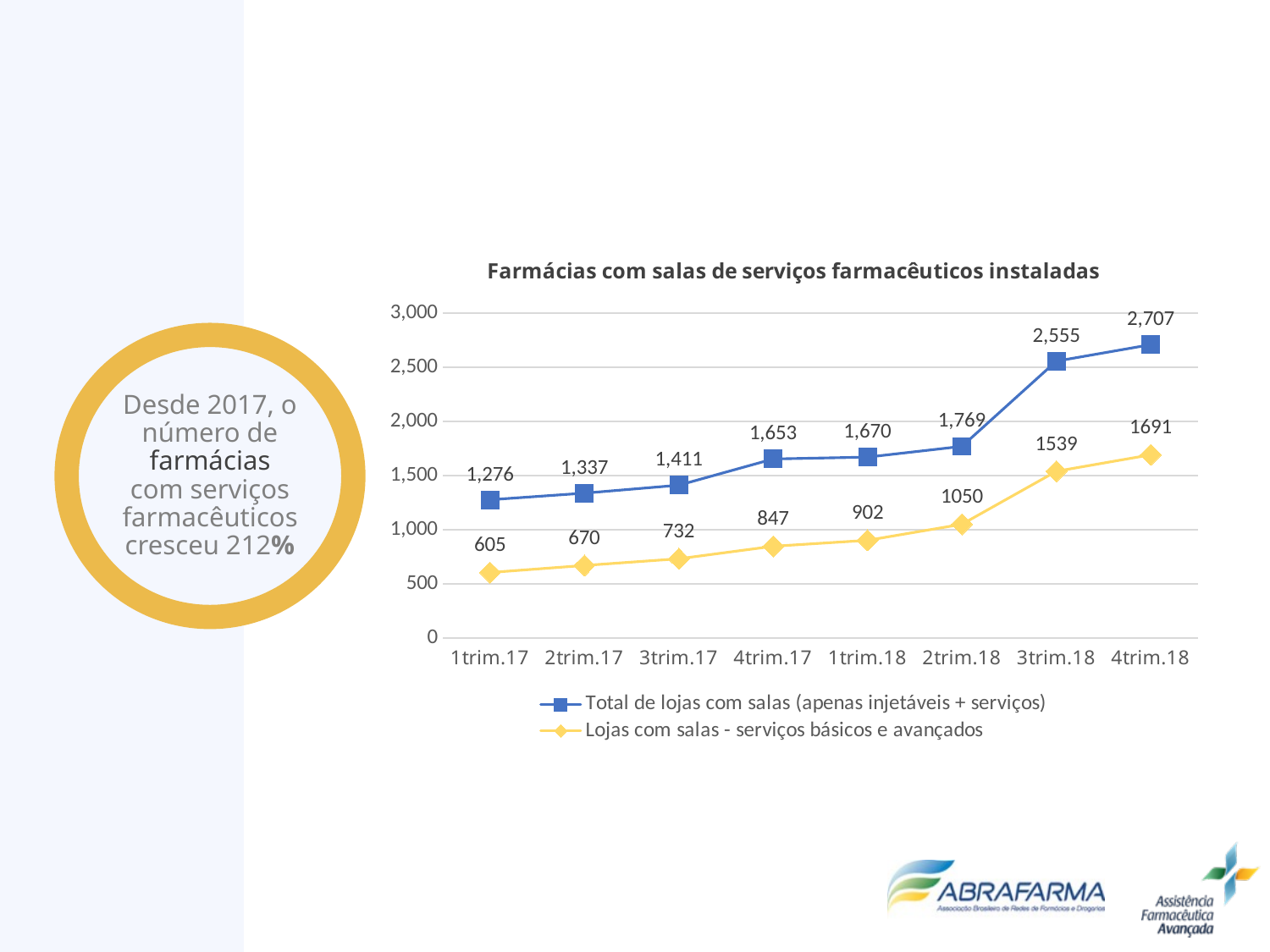
What is the difference between the 'Total de lojas com salas' values for 4trim.18 and 3trim.18? 152 What is the value of 'Lojas com salas - serviços básicos e avançados' for 1trim.17? 605 What kind of chart is shown on the slide? Line chart What is the value of 'Lojas com salas - serviços básicos e avançados' for 2trim.18? 1050 How many quarters are shown on the x axis? 8 What is the title of the chart? Farmácias com salas de serviços farmacêuticos instaladas What is the value of 'Total de lojas com salas (apenas injetáveis + serviços)' for 3trim.17? 1,411 Which quarter has the lowest value for 'Lojas com salas - serviços básicos e avançados'? 1trim.17 Which is larger: 'Lojas com salas - serviços básicos e avançados' in 4trim.18 or 'Total de lojas com salas' in 1trim.17? Lojas com salas - serviços básicos e avançados in 4trim.18 What is the value of 'Total de lojas com salas (apenas injetáveis + serviços)' for 4trim.18? 2,707 Which quarter has the highest value for 'Total de lojas com salas (apenas injetáveis + serviços)'? 4trim.18 How many series does the legend list? 2